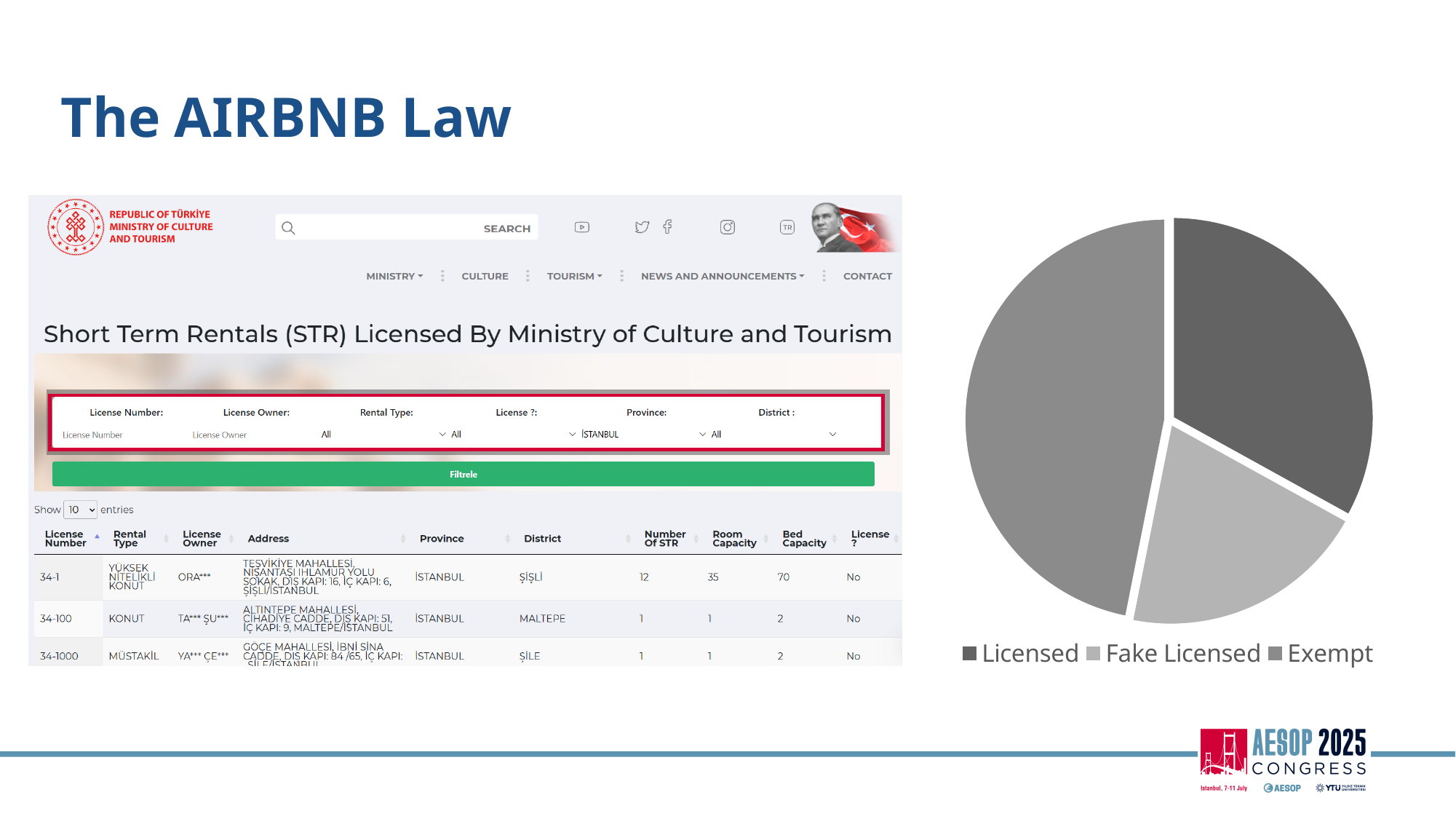
In the pie chart, which slice is larger: Licensed or Fake Licensed? Licensed In the pie chart, which slice is larger: Exempt or Fake Licensed? Exempt Which category in the pie chart is shown in the lightest grey? Fake Licensed Which category has the largest slice in the pie chart? Exempt How many entries does the pie chart's legend list? 3 What are the three categories listed in the pie chart's legend? Licensed, Fake Licensed, Exempt In the pie chart, which slice is larger: Exempt or Licensed? Exempt What kind of chart is shown on the right side of the slide? pie chart How many slices does the pie chart have? 3 Which category has the smallest slice in the pie chart? Fake Licensed